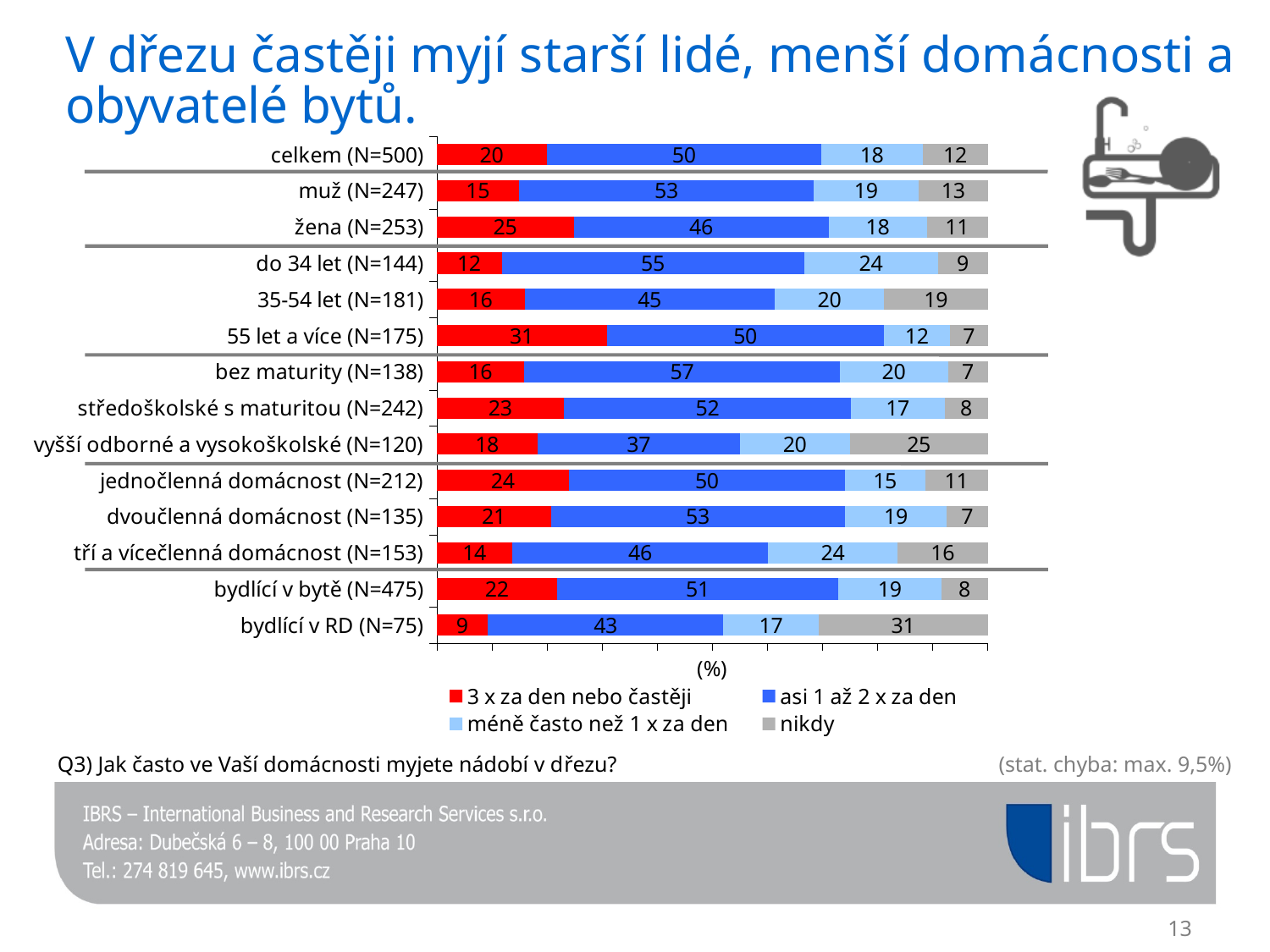
What is the value for "3 x za den nebo častěji" in the "celkem (N=500)" row? 20 What type of chart is shown on the slide? stacked bar chart What is the value for "nikdy" in the "bydlící v RD (N=75)" row? 31 Which colour represents the "nikdy" series in the chart? grey Which category has the lowest value for "3 x za den nebo častěji"? bydlící v RD (N=75) What is the value for "asi 1 až 2 x za den" in the "bez maturity (N=138)" row? 57 What is the total of the stacked bar for "do 34 let (N=144)"? 100 Which is larger: the "nikdy" value for "vyšší odborné a vysokoškolské (N=120)" or for "bez maturity (N=138)"? vyšší odborné a vysokoškolské (N=120) How many series does the legend list? 4 How many categories (rows) are plotted in the chart? 14 What is the difference between the "3 x za den nebo častěji" values for "žena (N=253)" and "muž (N=247)"? 10 Which category has the highest value for "3 x za den nebo častěji"? 55 let a více (N=175)